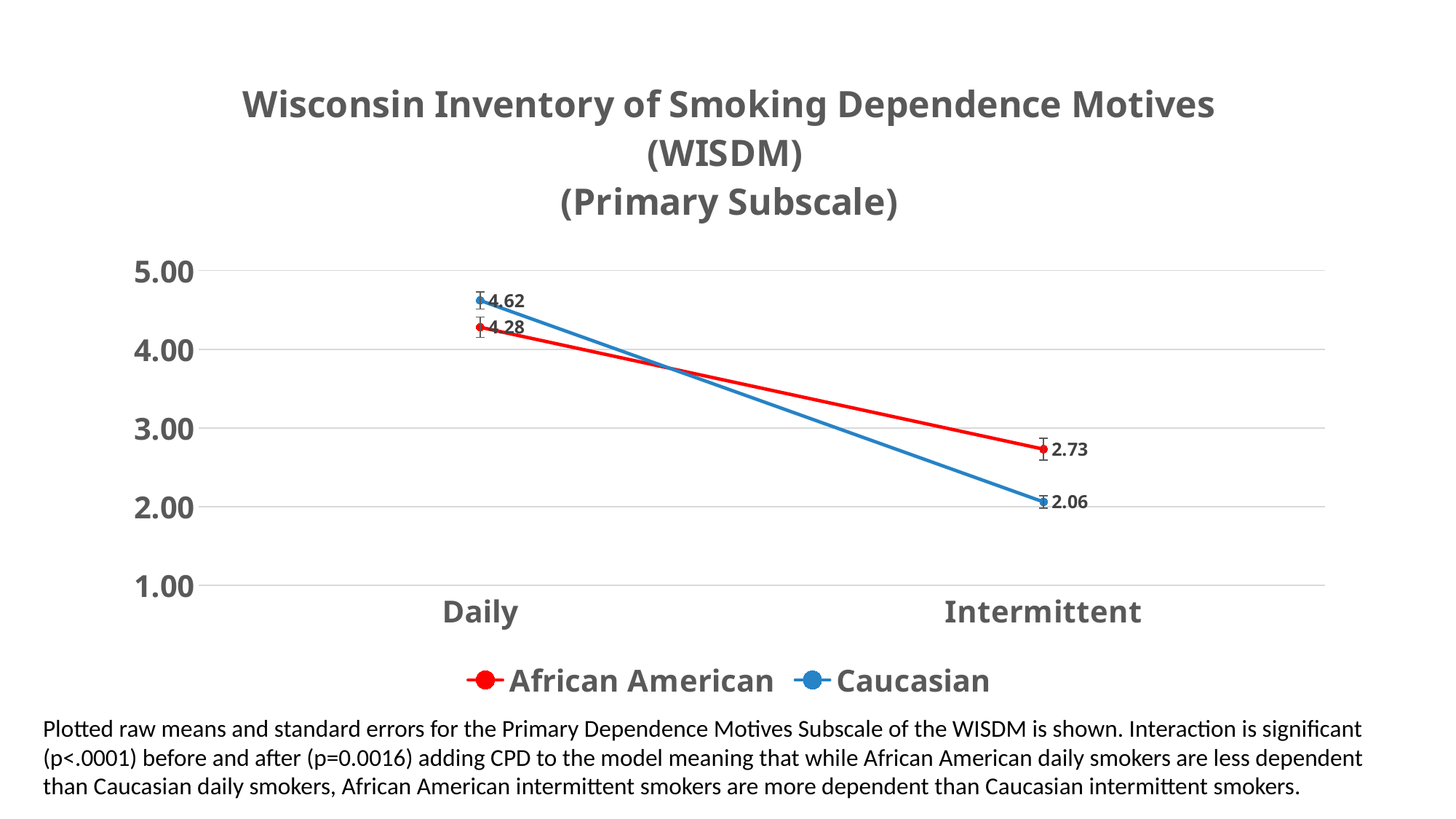
What is the value for African American intermittent smokers? 2.73 What is the value for Caucasian daily smokers? 4.62 What is the value for Caucasian intermittent smokers? 2.06 Which group has the lowest value on the chart? Caucasian intermittent smokers Do the values for the Caucasian series rise or fall from Daily to Intermittent? Fall What is the difference between the African American and Caucasian values for intermittent smokers? 0.67 What kind of chart is shown? Line chart What is the difference between the Caucasian and African American values for daily smokers? 0.34 For intermittent smokers, which series has the larger value, African American or Caucasian? African American What is the value for African American daily smokers? 4.28 How many series does the legend list? 2 Which group has the highest value on the chart? Caucasian daily smokers